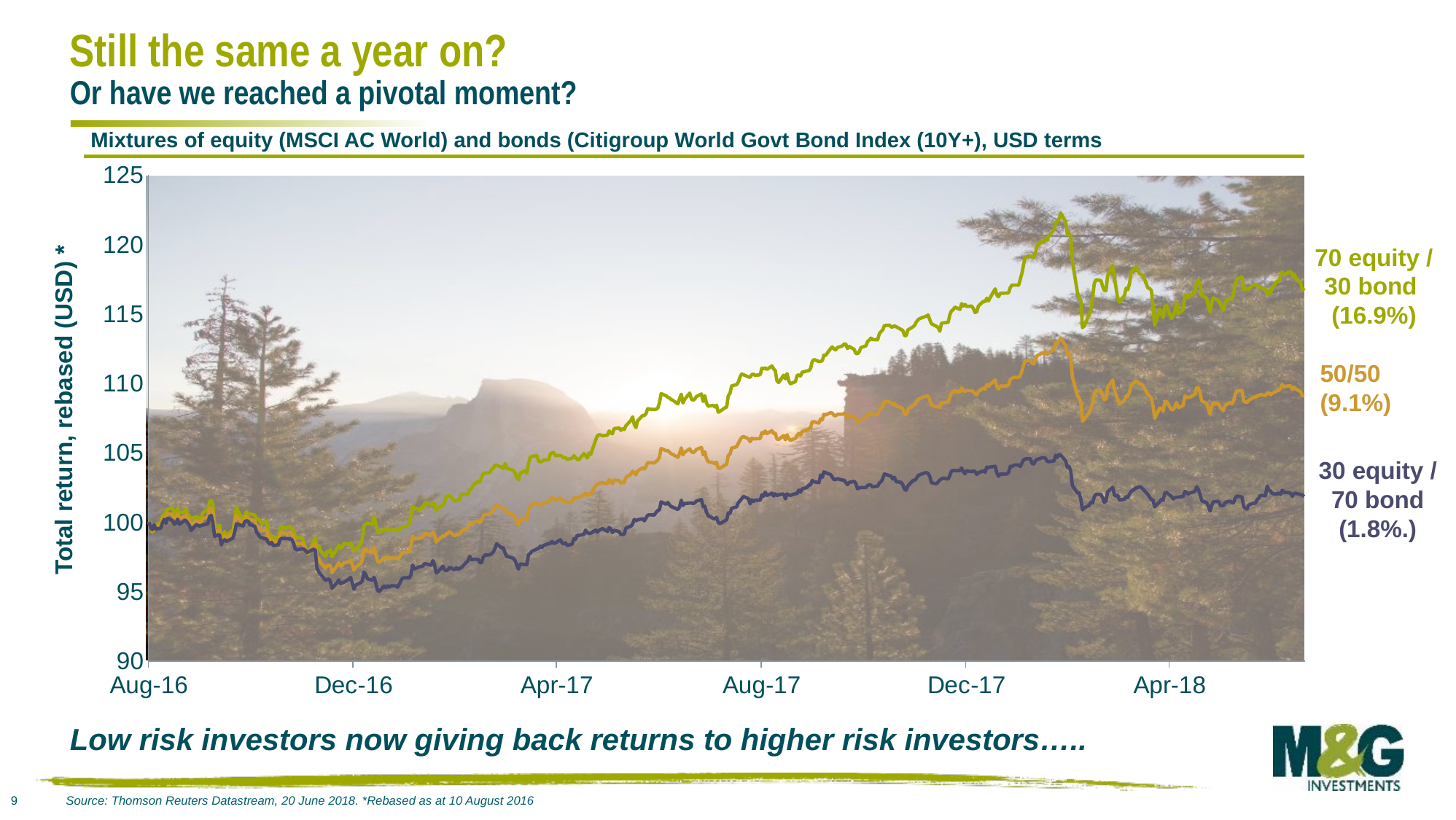
Which mixture has the lowest return shown? 30 equity / 70 bond What is the label on the vertical axis of the chart? Total return, rebased (USD) * Is the peak value of the 70 equity / 30 bond line greater or less than 120? greater Overall, do the lines rise or fall from Aug-16 to the end of the chart? Rise What return is shown for the 70 equity / 30 bond mixture? 16.9% Which mixture has the highest return shown? 70 equity / 30 bond How many series (portfolio mixtures) are plotted on the chart? 3 What return is shown for the 30 equity / 70 bond mixture? 1.8% What kind of chart is shown on the slide? Line chart What is the difference between the returns of the 70 equity / 30 bond mixture and the 50/50 mixture? 7.8 percentage points What return is shown for the 50/50 mixture? 9.1% Which has the larger return, the 50/50 mixture or the 30 equity / 70 bond mixture? 50/50